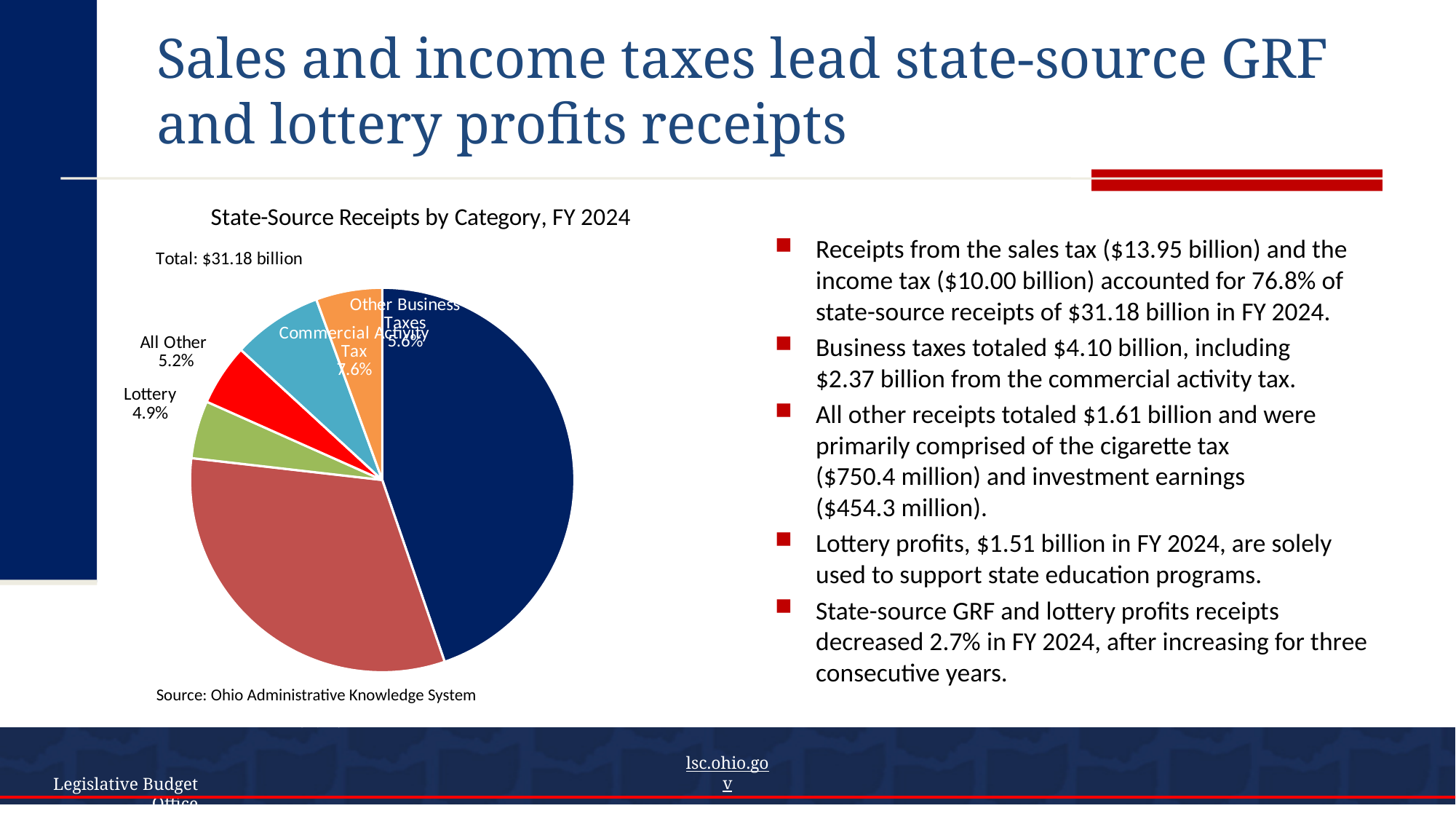
What total amount is printed above the pie chart? $31.18 billion Among the labeled slices, which category has the smallest share? Lottery What is the difference in percentage points between the Commercial Activity Tax share and the Other Business Taxes share? 2.0 percentage points What share of state-source receipts does the Commercial Activity Tax slice represent? 7.6% What share of state-source receipts does the Other Business Taxes slice represent? 5.6% Which is larger, the Commercial Activity Tax share or the Other Business Taxes share? Commercial Activity Tax What is the title of the chart? State-Source Receipts by Category, FY 2024 What share of state-source receipts does the All Other slice represent? 5.2% Which is larger, the All Other share or the Lottery share? All Other How many slices does the pie chart have? 6 What share of state-source receipts does the Lottery slice represent? 4.9% What type of chart is shown on the slide? Pie chart